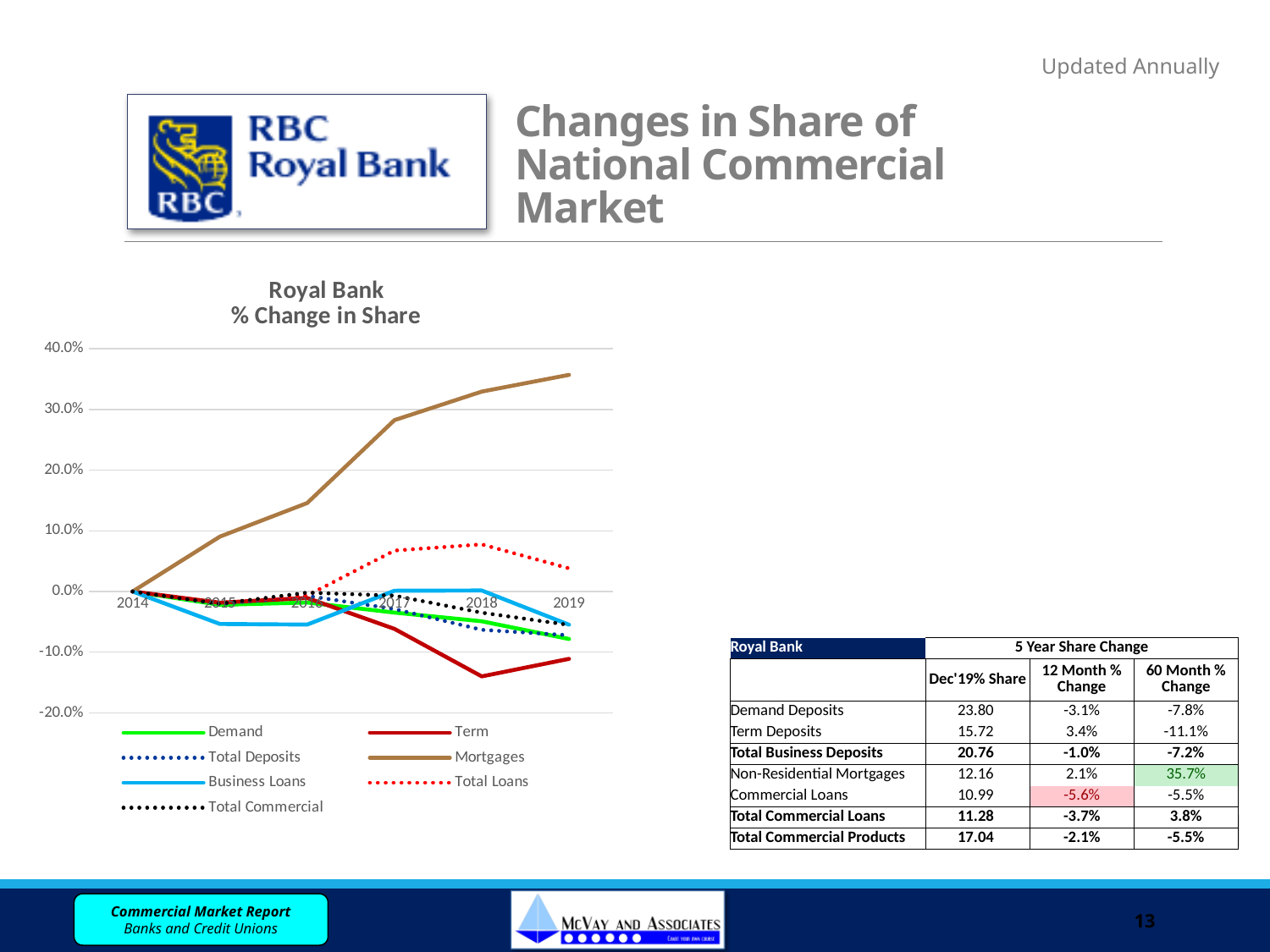
Which series has the highest value in 2019? Mortgages How many series does the chart legend list? 7 Is the value for Term in 2018 greater or less than -10.0%? less How many years are shown along the x axis of the chart? 6 Which series is drawn as a solid brown line in the chart? Mortgages Is the value for Total Loans in 2018 greater or less than 0.0%? greater Which series has the lowest value in 2018? Term In 2019, which is larger: the value for Mortgages or the value for Term? Mortgages What is the title of the chart? Royal Bank % Change in Share Is the value for Mortgages in 2019 greater or less than 30.0%? greater What kind of chart is shown on the slide? line chart Does the Mortgages line rise or fall from 2014 to 2019? rise